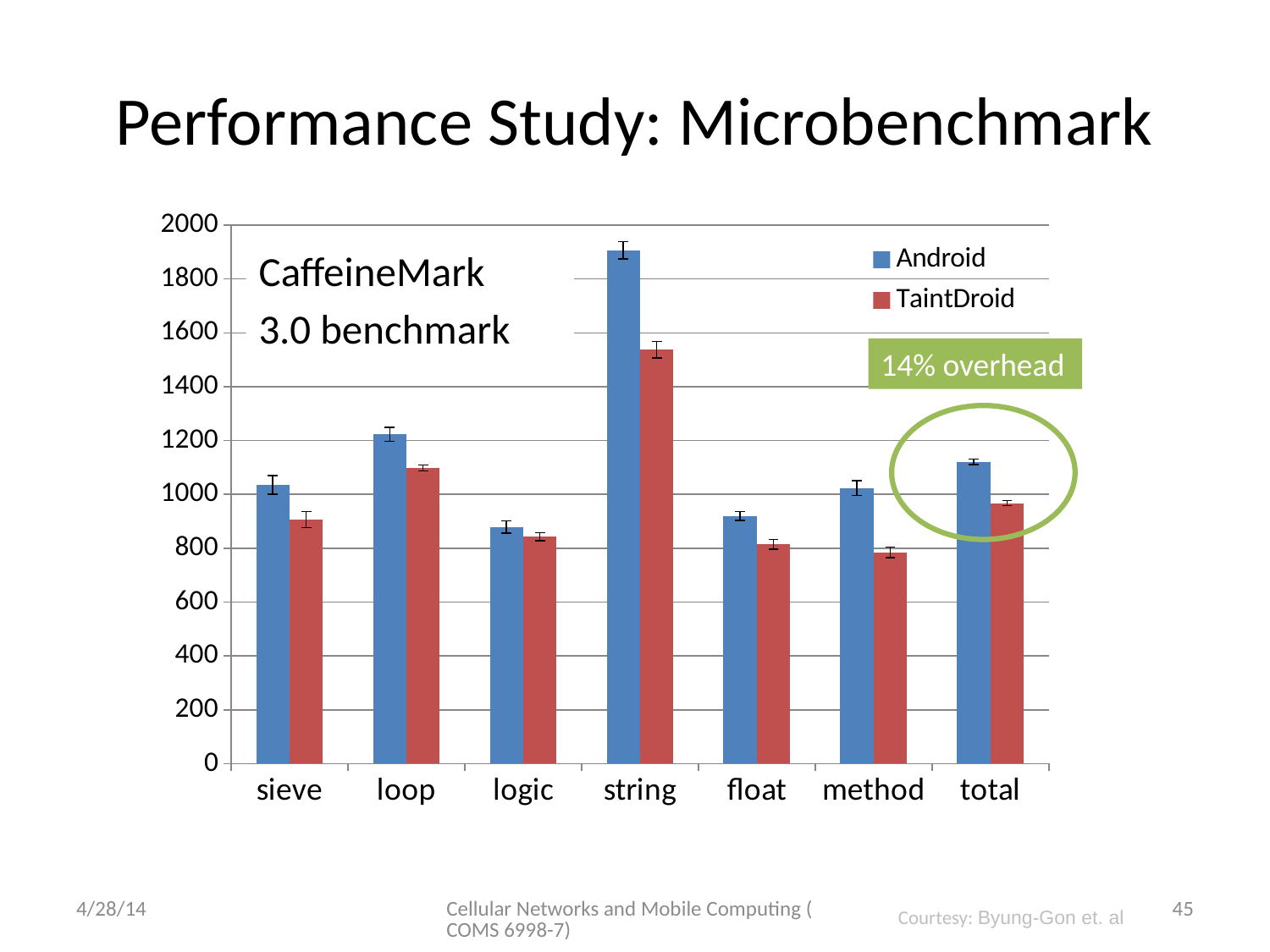
Which category has the highest Android value? string Is the TaintDroid value for string greater or less than 1400? greater What kind of chart is shown on the slide? bar chart What overhead percentage is stated in the green callout on the chart? 14% overhead Is the Android value for total greater or less than 1000? greater Is the Android value for string greater or less than 1800? greater How many series does the legend list? 2 Which category has the lowest Android value? logic How many benchmark categories are shown on the x axis? 7 For the string benchmark, which is larger: the Android value or the TaintDroid value? Android Which category has the highest TaintDroid value? string